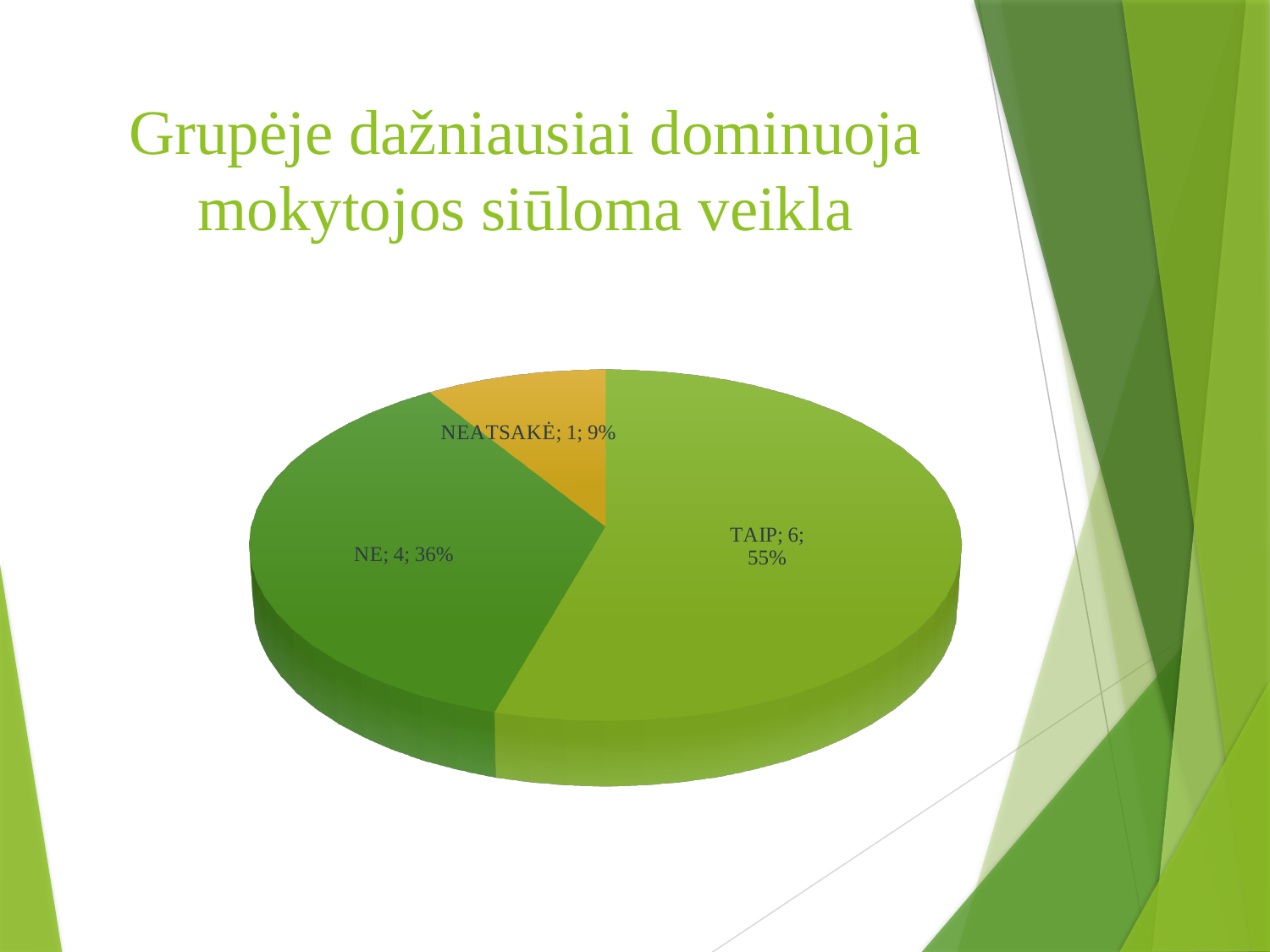
What share of the pie does the NE slice represent? 36% What share of the pie does the NEATSAKĖ slice represent? 9% What is the count for the TAIP slice? 6 What kind of chart is shown on the slide? pie chart How many slices does the pie chart have? 3 Which slice is larger, NE or NEATSAKĖ? NE What is the difference in count between the TAIP and NE slices? 2 What is the count for the NEATSAKĖ slice? 1 What share of the pie does the TAIP slice represent? 55% Which slice is the smallest? NEATSAKĖ What is the count for the NE slice? 4 Which slice is the largest? TAIP